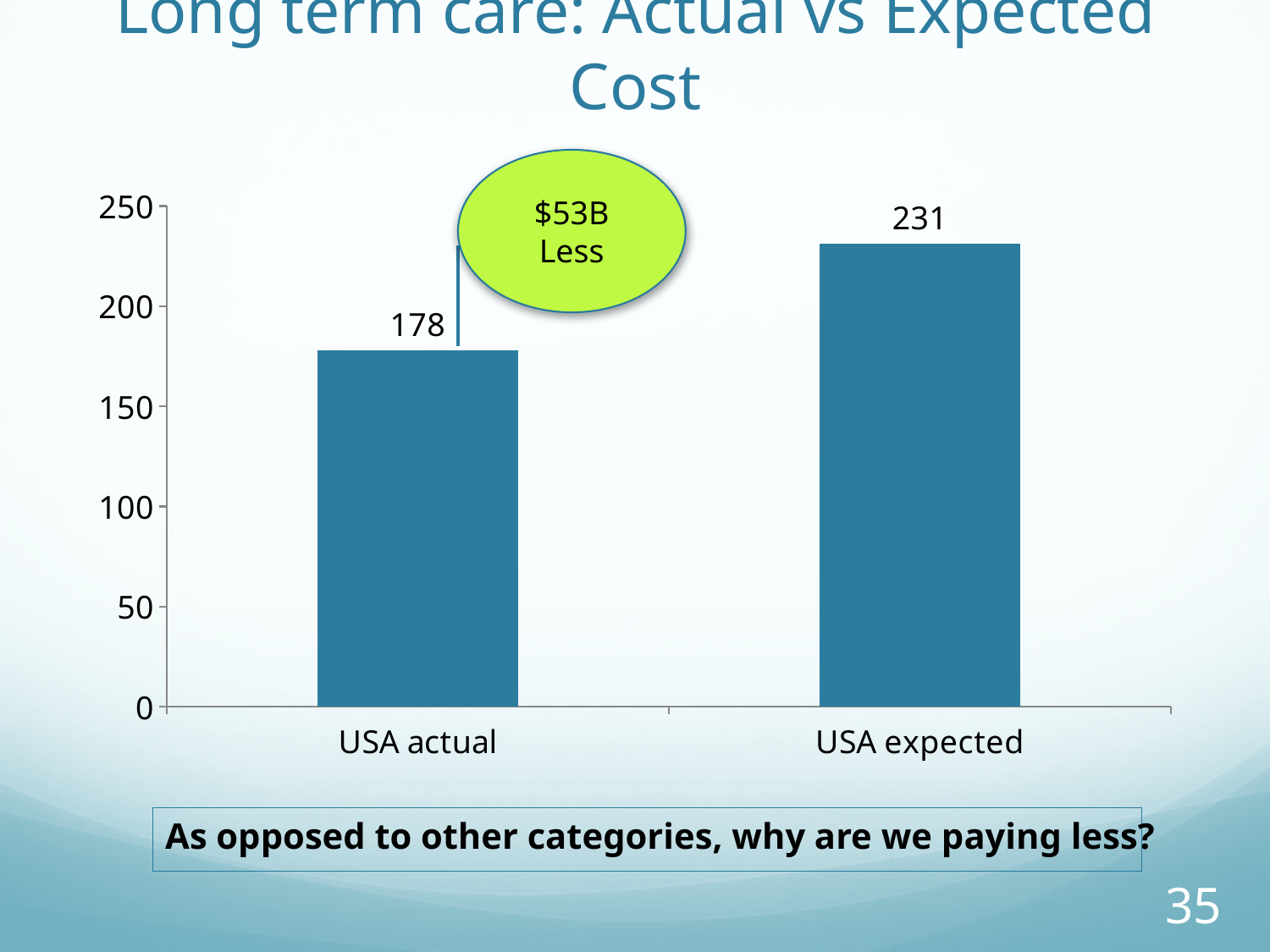
Is the value for USA actual greater or less than 200? less Which category has the lowest value? USA actual What is the value for USA expected? 231 What is the difference between USA expected and USA actual? 53 Which is larger, USA actual or USA expected? USA expected What is the title of the chart? Long term care: Actual vs Expected Cost Is the value for USA expected greater or less than 200? greater What does the green callout on the chart say? $53B Less What is the value for USA actual? 178 Which category has the highest value? USA expected How many categories are shown on the chart? 2 What kind of chart is shown on the slide? bar chart